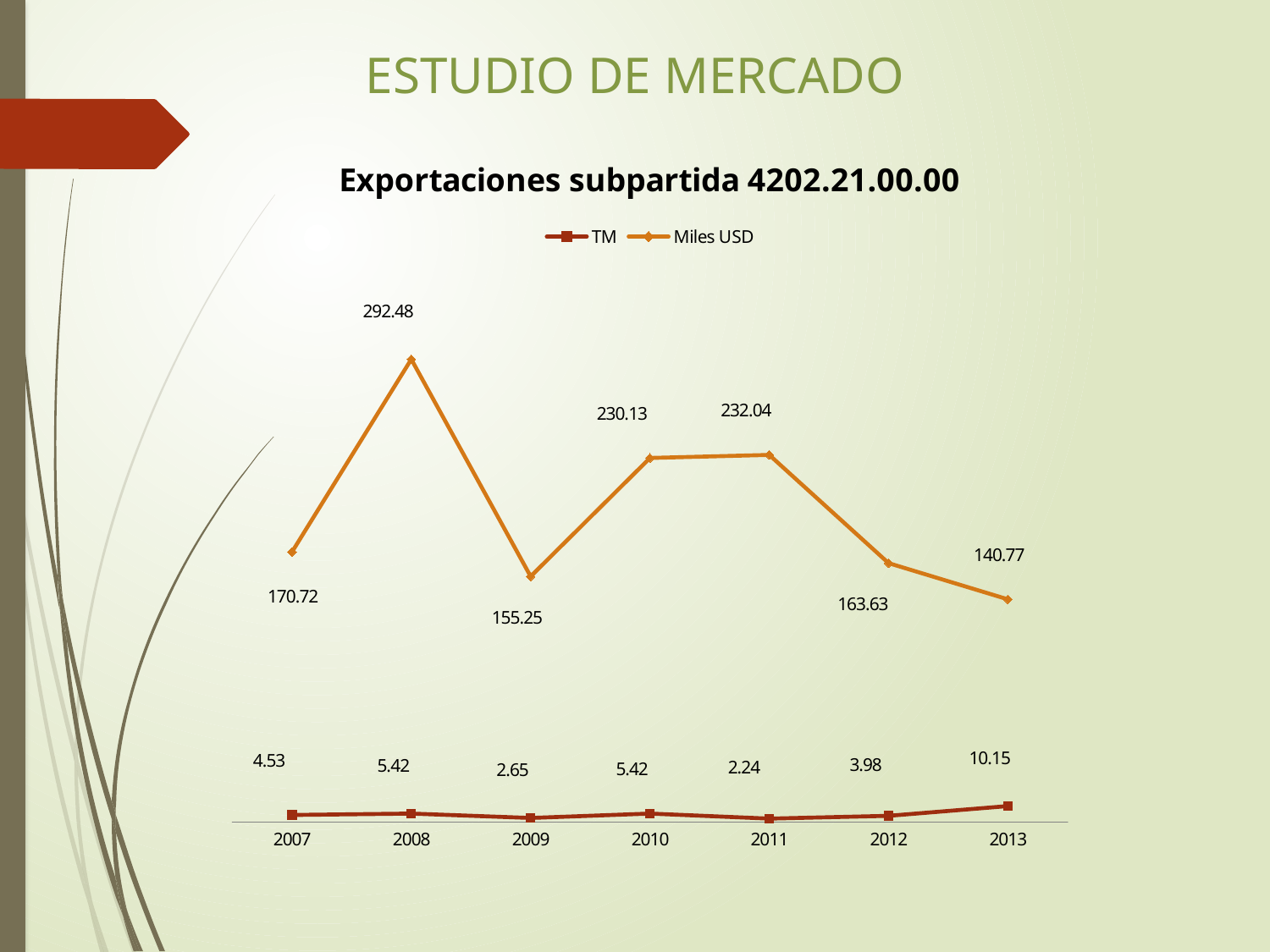
How many series does the legend list? 2 What is the Miles USD value for 2008? 292.48 What is the title of the chart? Exportaciones subpartida 4202.21.00.00 In which year is the TM value lowest? 2011 Which year has the larger TM value, 2007 or 2012? 2007 How many years are shown on the x axis? 7 In which year is the Miles USD value highest? 2008 What kind of chart is shown on the slide? Line chart In which year is the Miles USD value lowest? 2013 What is the TM value for 2013? 10.15 What is the difference between the Miles USD values for 2008 and 2009? 137.23 What is the Miles USD value for 2012? 163.63